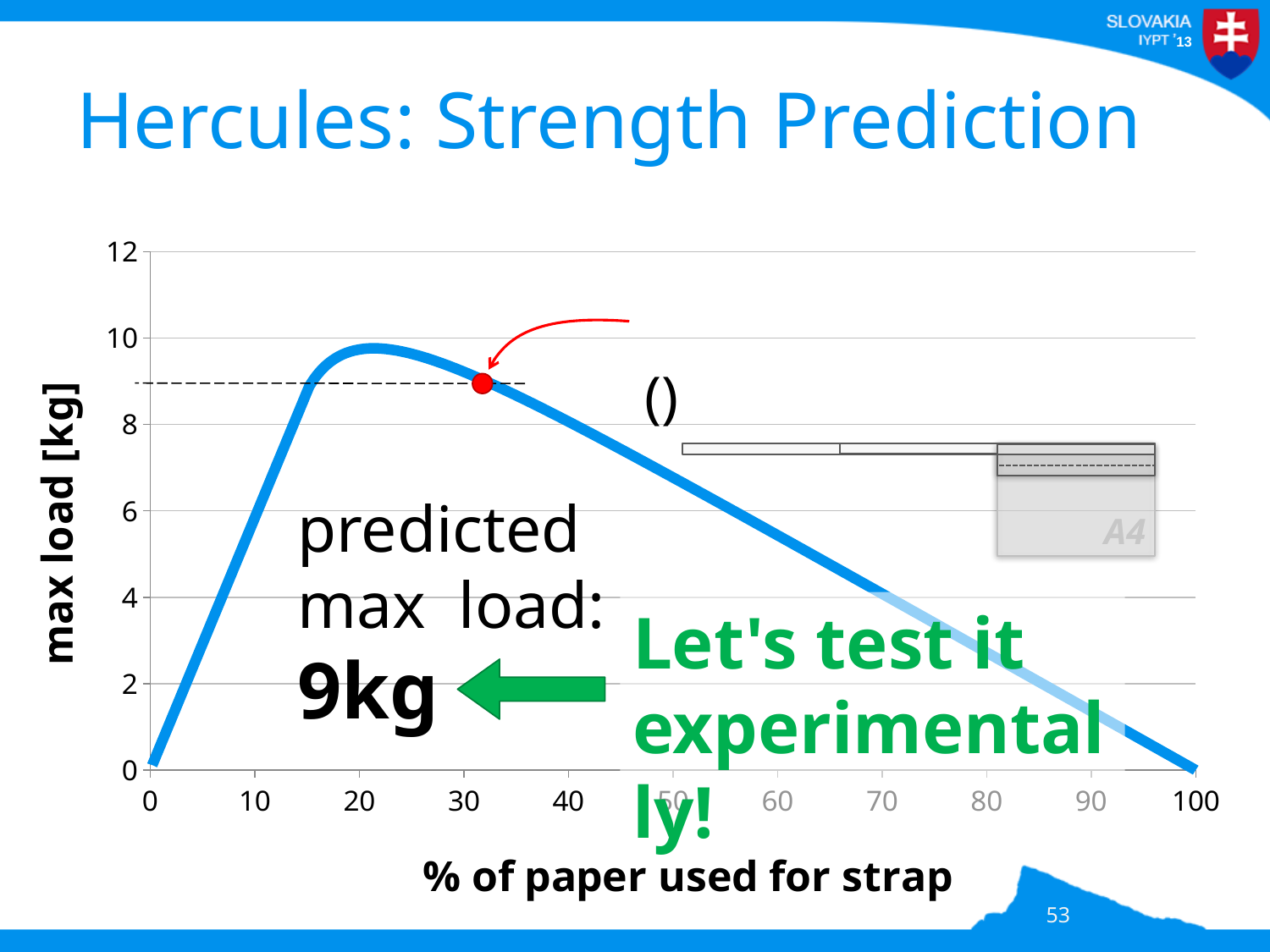
Does the max load rise or fall as the % of paper used for strap increases from 40 to 100? fall What is the label of the x axis? % of paper used for strap Is the max load at 90% of paper used for strap greater or less than 4 kg? less What is the max load at 100% of paper used for strap? 0 What predicted max load is annotated on the chart? 9kg What is the max load at 0% of paper used for strap? 0 Which has a higher max load: 20% of paper used for strap or 80%? 20% Is the peak value of the curve greater or less than 8 kg? greater What is the label of the y axis? max load [kg] Is the max load at 20% of paper used for strap greater or less than 8 kg? greater What kind of chart is shown on the slide? line chart